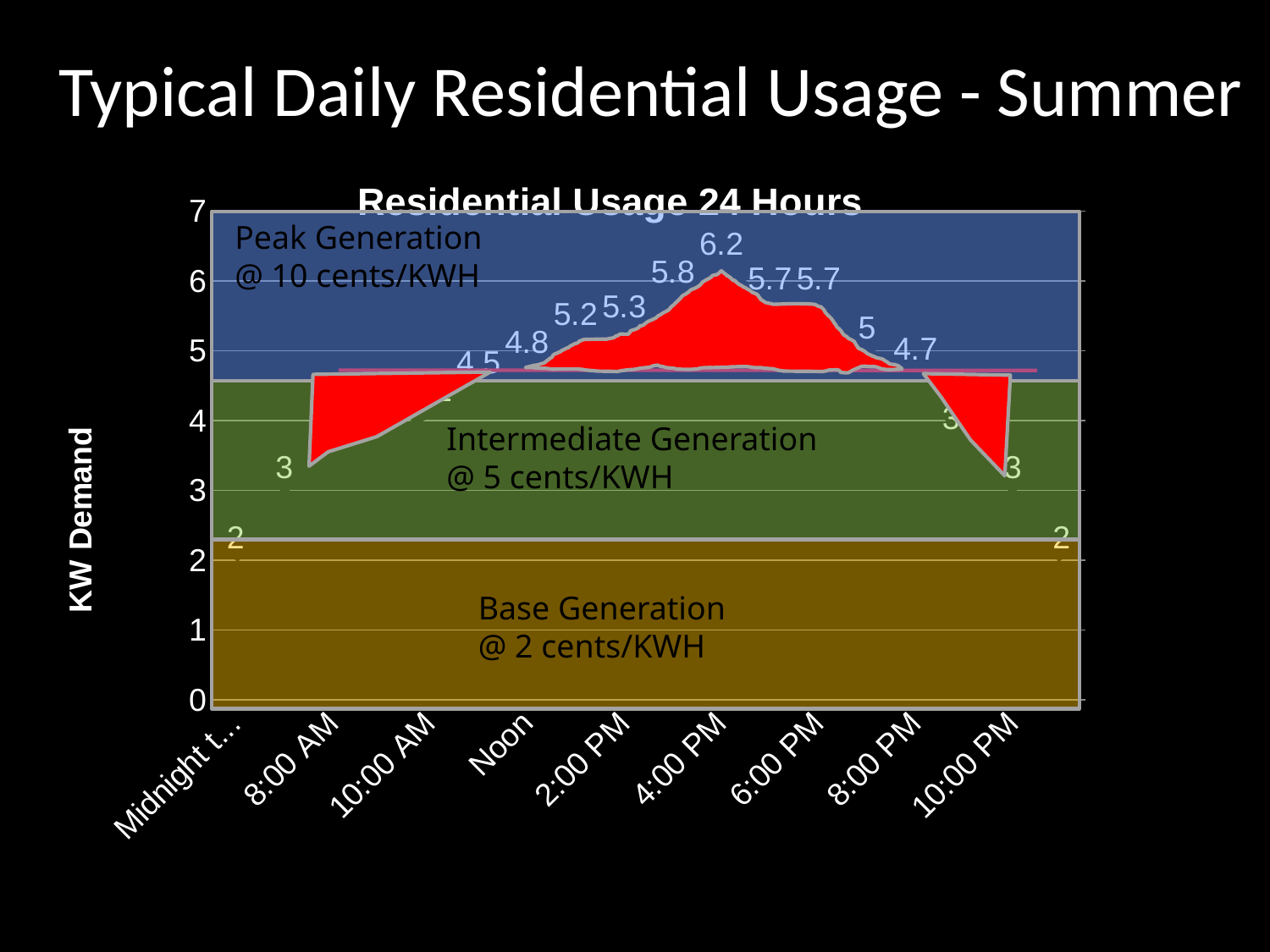
What is the KW Demand value at 8:00 PM? 4.7 What is the KW Demand value at 10:00 PM? 3 What kind of chart is shown on the slide? line chart At which time of day is KW Demand highest? 4:00 PM What is the KW Demand value at Noon? 4.8 Does KW Demand rise or fall from Noon to 4:00 PM? rise What is the KW Demand value at 4:00 PM? 6.2 What is the difference in KW Demand between 4:00 PM and 8:00 PM? 1.5 Which has the higher KW Demand, Noon or 6:00 PM? 6:00 PM Is the KW Demand at 4:00 PM greater or less than 6? greater What is the KW Demand value at 2:00 PM? 5.3 What is the title of the chart? Residential Usage 24 Hours